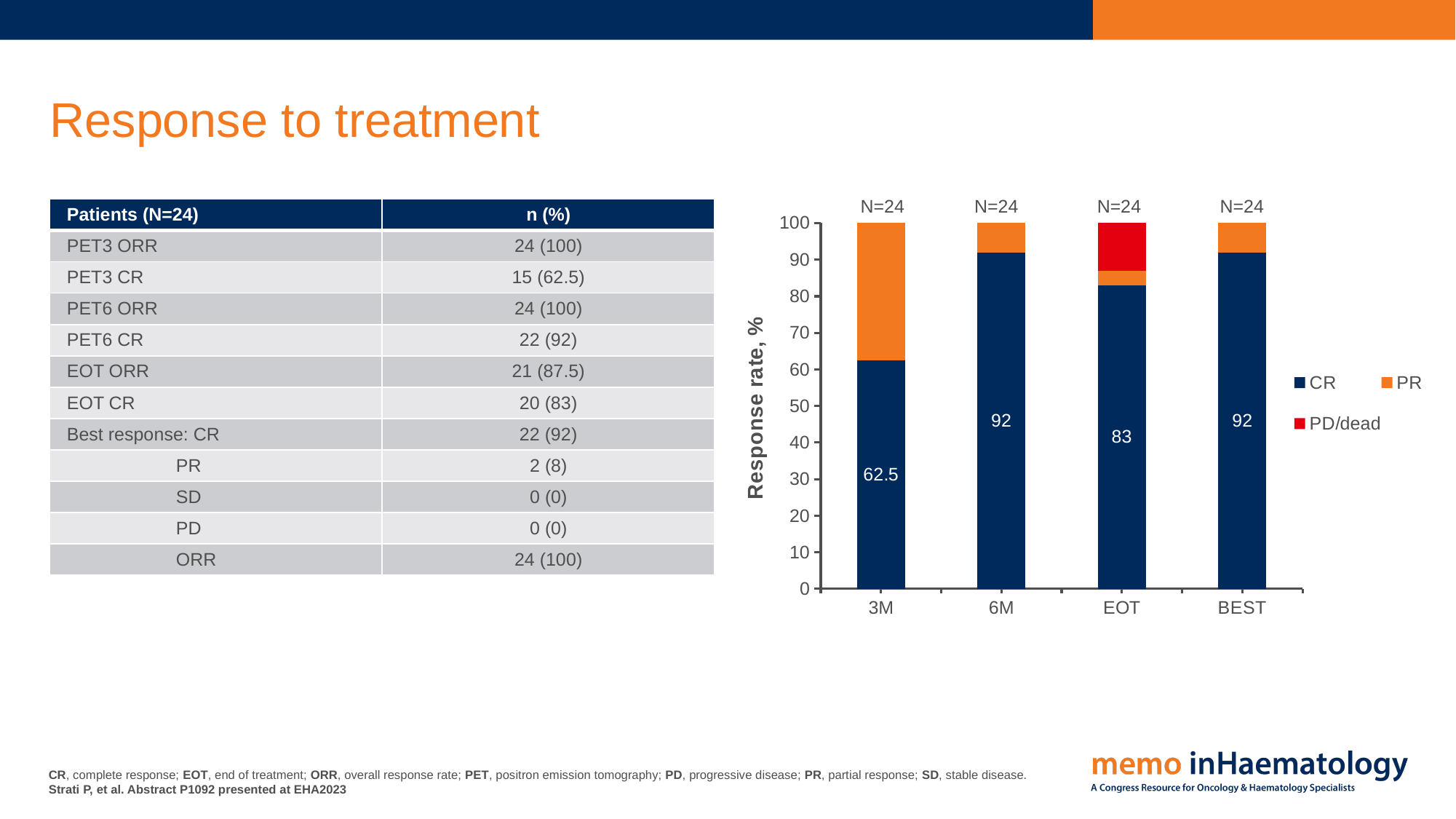
Is the PR value for 3M greater or less than 20? greater Which category has the lowest CR value? 3M How many categories are shown on the x axis? 4 What is the CR value for the BEST bar? 92 How many series does the legend list? 3 What is the CR value for the 3M bar? 62.5 What kind of chart is shown on the slide? Stacked bar chart What is the difference between the CR value at 6M and the CR value at EOT? 9 Does the CR value rise or fall from 3M to 6M? Rise Which has the larger CR value, 6M or EOT? 6M What is the difference between the CR value at BEST and the CR value at 3M? 29.5 What is the CR value for the EOT bar? 83